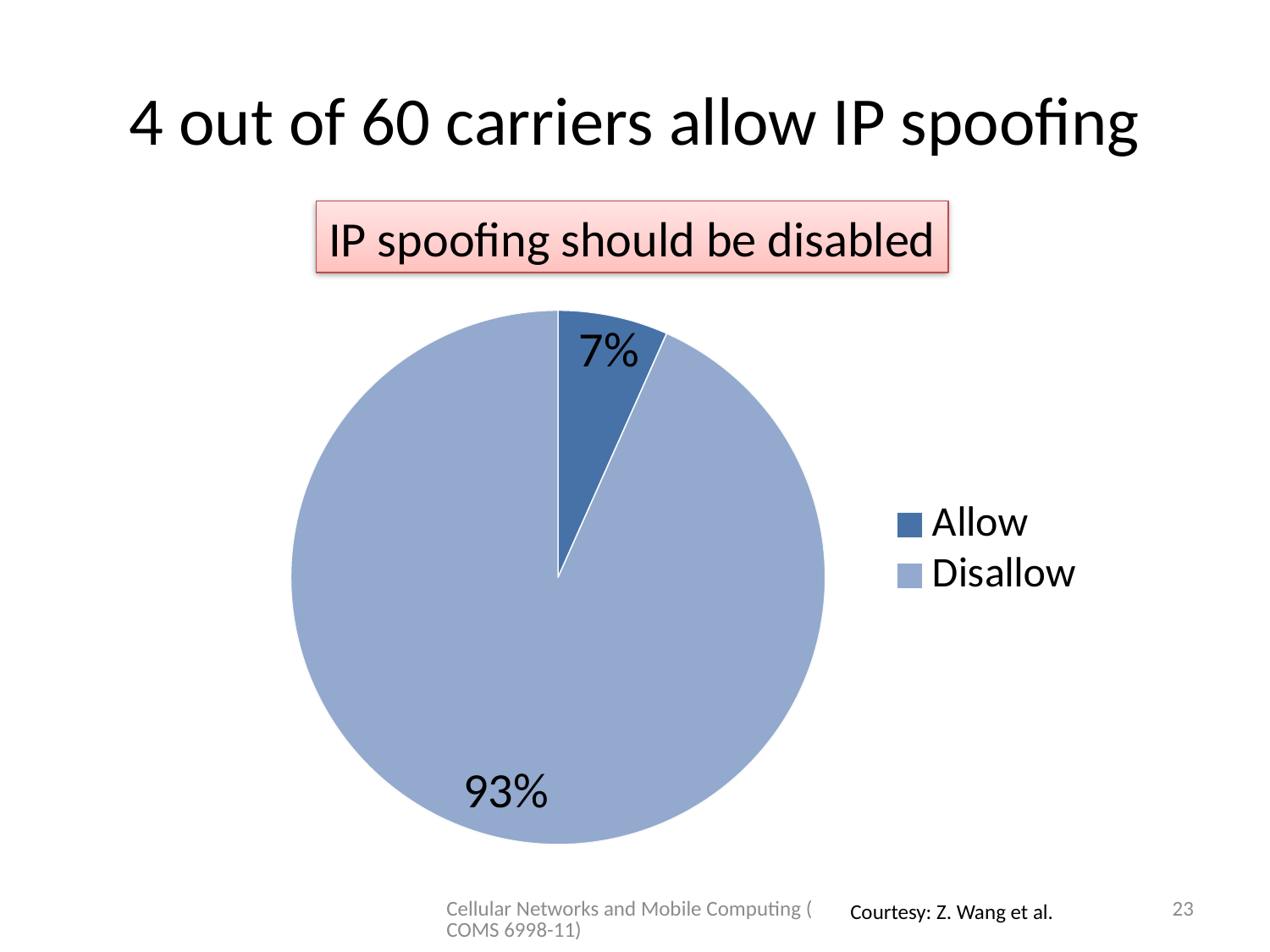
Which slice of the pie is the largest? Disallow What share of the pie does the Disallow slice represent? 93% What is the difference in percentage points between the Disallow and Allow slices? 86 What share of the pie does the Allow slice represent? 7% Which is larger, the Allow slice or the Disallow slice? Disallow What is the title of the slide containing the pie chart? 4 out of 60 carriers allow IP spoofing Which legend entry is shown in the darker blue colour? Allow How many slices does the pie chart have? 2 How many entries does the legend list? 2 What kind of chart is shown on the slide? pie chart Which slice of the pie is the smallest? Allow